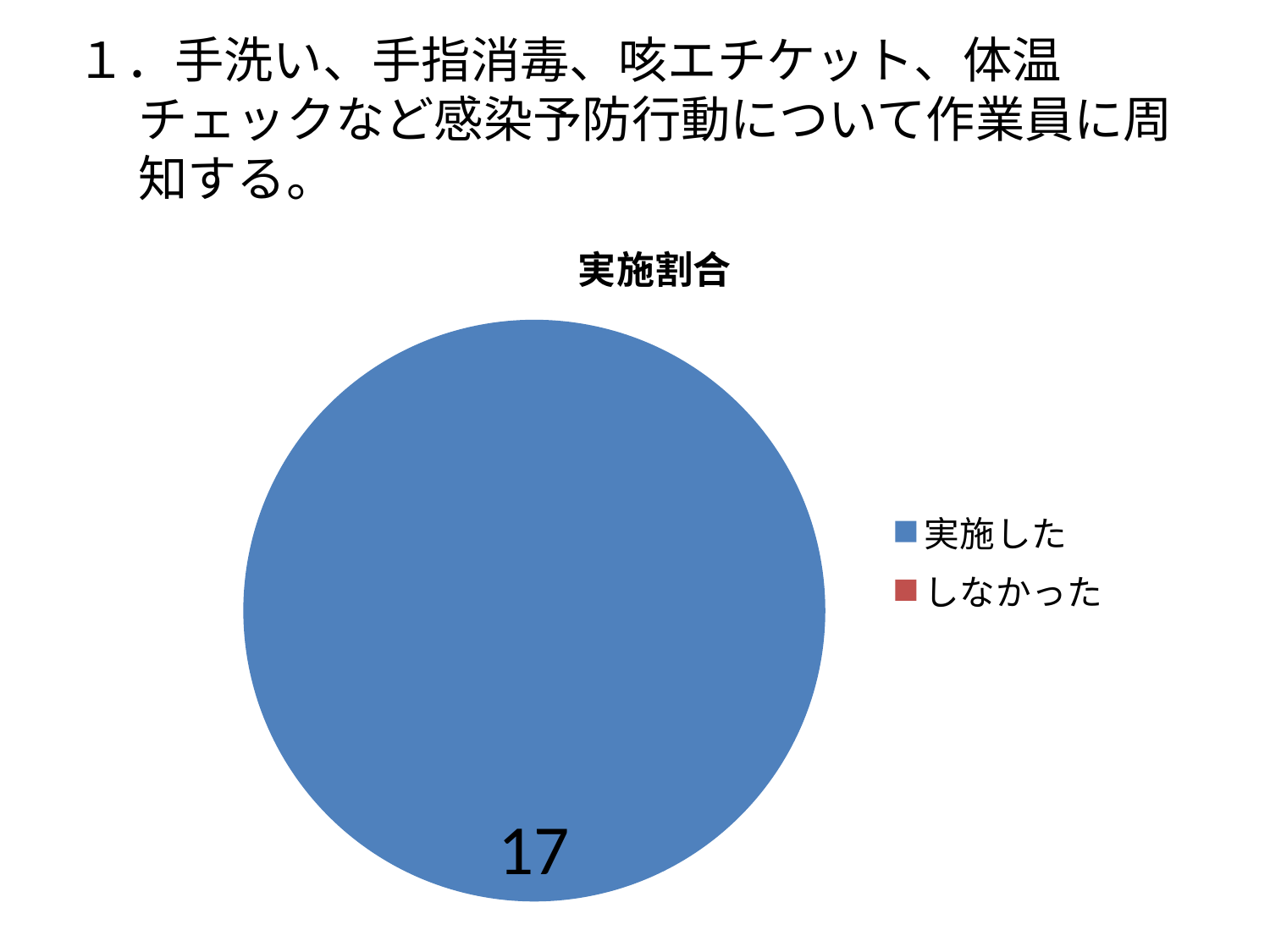
How many categories are listed for the pie chart? 2 What colour represents 実施した in the legend? blue Which is larger, the slice for 実施した or the slice for しなかった? 実施した Which category has the largest slice of the pie? 実施した How many entries does the chart legend list? 2 What value is printed on the 実施した slice of the pie? 17 What is the title of the chart? 実施割合 What kind of chart is shown on the slide? pie chart Which category has the smallest slice of the pie? しなかった